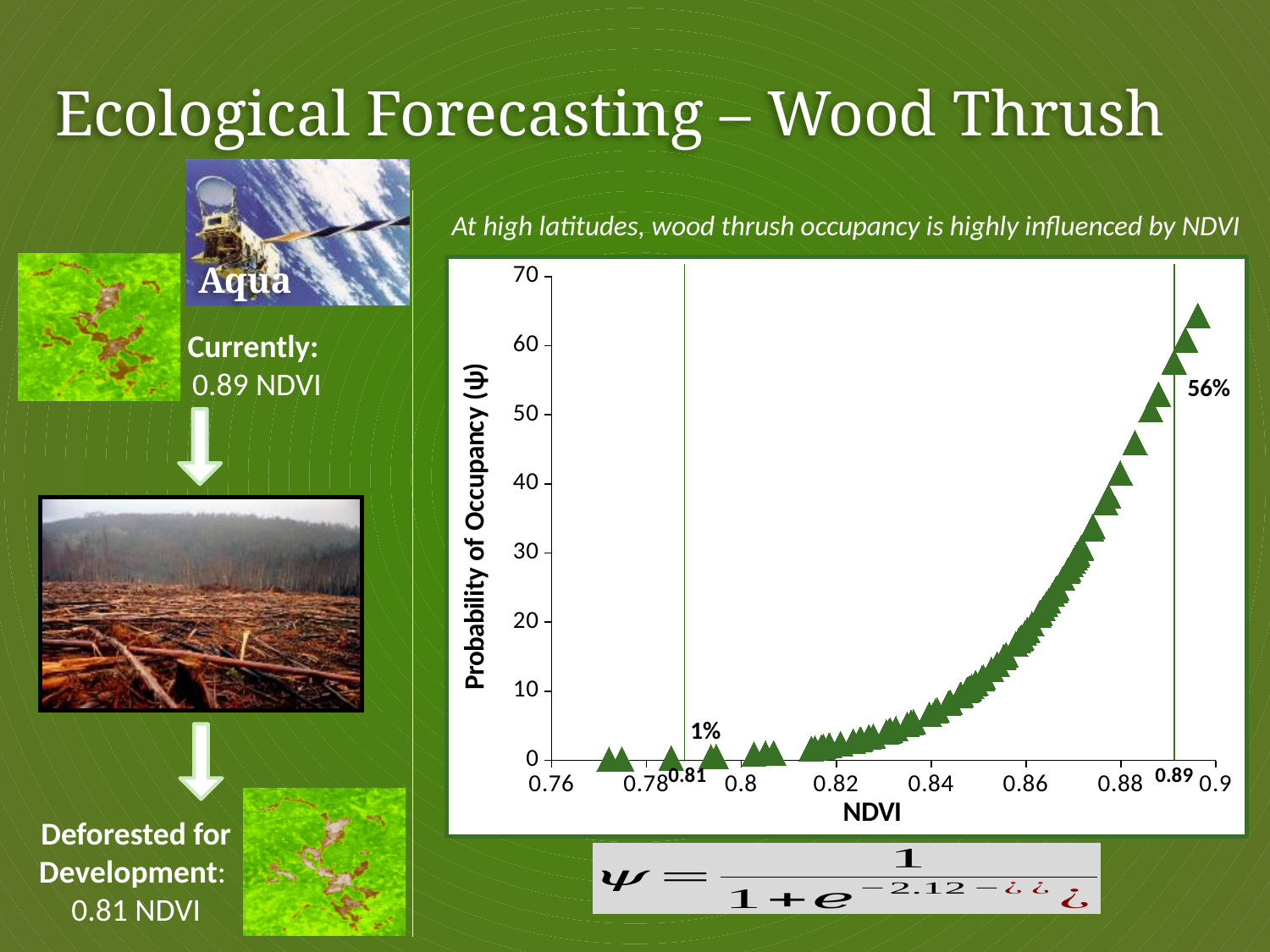
What type of chart is shown on the slide? scatter chart Is the probability of occupancy at an NDVI of 0.84 greater or less than 10? less What is the label of the x axis of the chart? NDVI Is the probability of occupancy at an NDVI of 0.88 greater or less than 30? greater Is the probability of occupancy at an NDVI of 0.86 greater or less than 10? greater What is the label of the y axis of the chart? Probability of Occupancy (ψ) What is the probability of occupancy labelled at an NDVI of 0.81? 1% What is the difference between the labelled probability of occupancy at NDVI 0.89 and at NDVI 0.81? 55% Which NDVI value has the higher labelled probability of occupancy, 0.81 or 0.89? 0.89 What is the probability of occupancy labelled at an NDVI of 0.89? 56% What is the highest value shown on the y axis of the chart? 70 Does the probability of occupancy rise or fall as NDVI increases along the x axis? rise